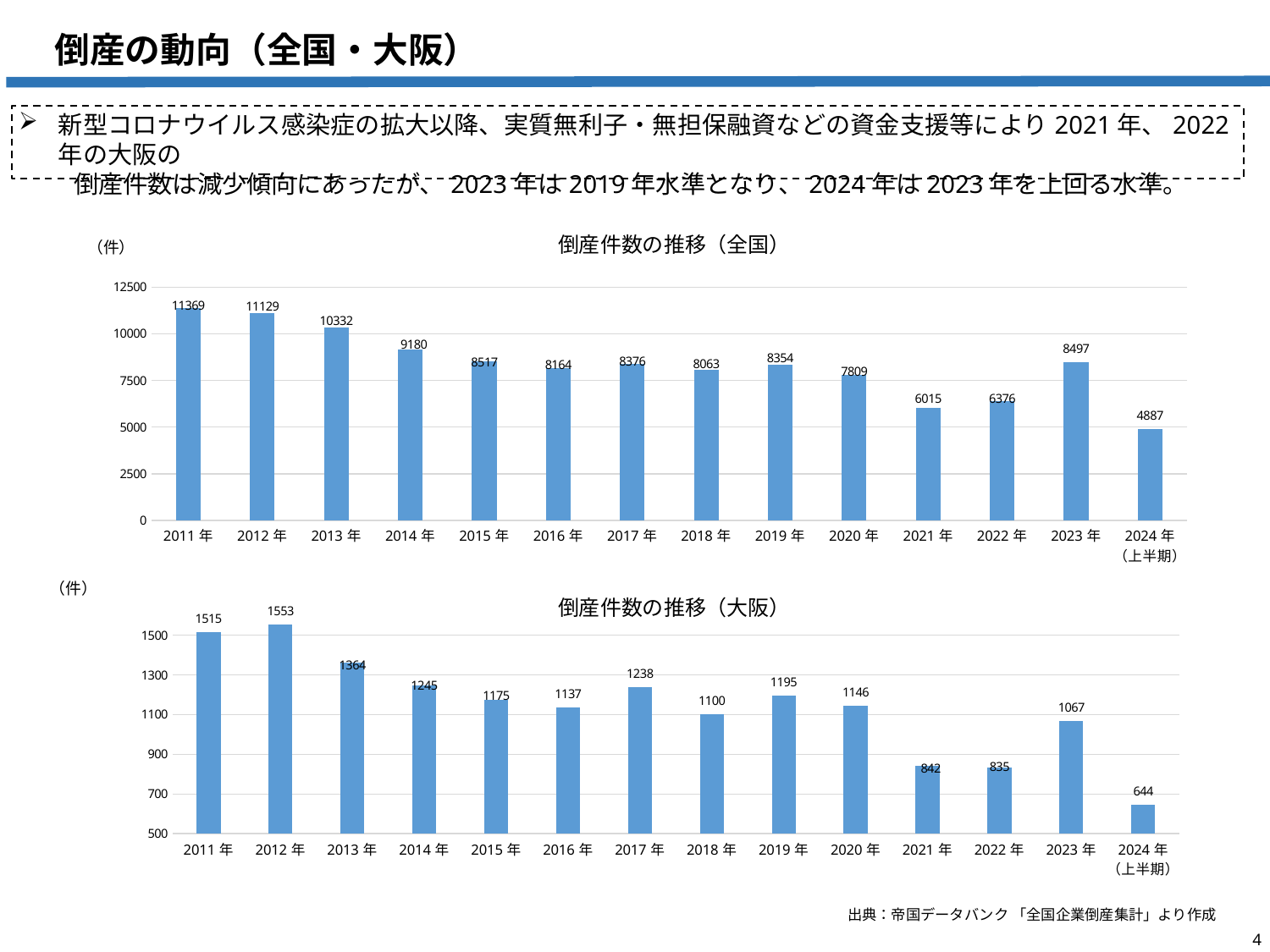
In the 倒産件数の推移（大阪） chart, which year has the highest value? 2012年 What kind of chart is the 倒産件数の推移（大阪） chart? bar chart In the 倒産件数の推移（大阪） chart, what is the value for 2024年（上半期）? 644 In the 倒産件数の推移（全国） chart, what is the value for 2021年? 6015 In the 倒産件数の推移（全国） chart, how many bars are plotted? 14 In the 倒産件数の推移（全国） chart, what is the difference between the values for 2023年 and 2022年? 2121 In the 倒産件数の推移（全国） chart, do the values rise or fall from 2011年 to 2014年? fall In the 倒産件数の推移（大阪） chart, which is larger, the value for 2019年 or the value for 2020年? 2019年 In the 倒産件数の推移（大阪） chart, what is the difference between the values for 2011年 and 2012年? 38 In the 倒産件数の推移（全国） chart, is the value for 2014年 greater or less than 10000? less In the 倒産件数の推移（大阪） chart, what is the value for 2017年? 1238 In the 倒産件数の推移（全国） chart, which year has the highest value? 2011年